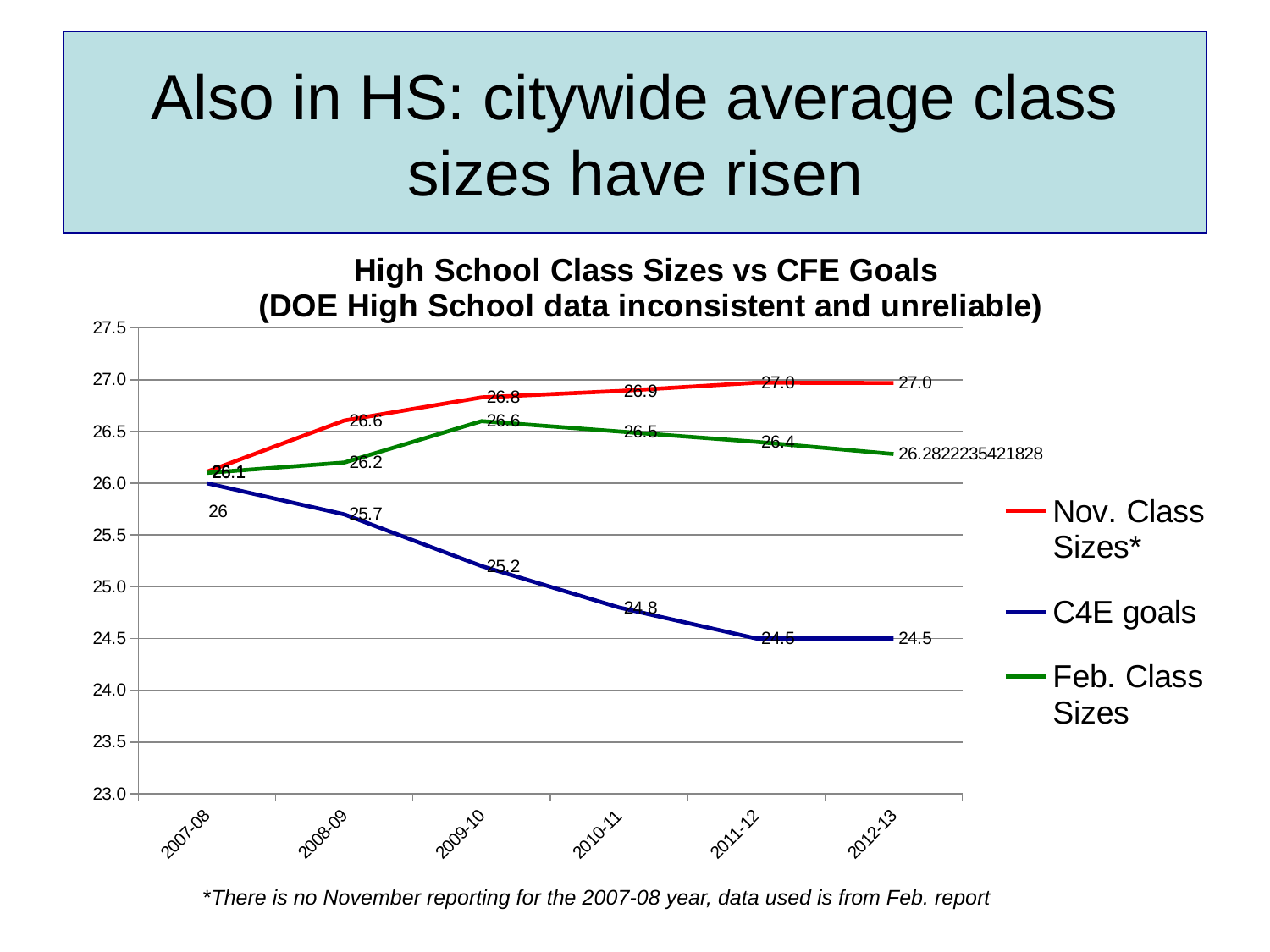
In 2008-09, which is larger: Nov. Class Sizes or Feb. Class Sizes? Nov. Class Sizes What is the C4E goals value for 2009-10? 25.2 What is the difference between the Nov. Class Sizes value and the C4E goals value in 2012-13? 2.5 What is the Feb. Class Sizes value for 2010-11? 26.5 How many school years are plotted along the x axis? 6 What kind of chart is shown on the slide? line chart In which year is the Nov. Class Sizes value lowest? 2007-08 What is the Nov. Class Sizes value for 2011-12? 27.0 How many series does the legend list? 3 What is the C4E goals value for 2008-09? 25.7 Do the C4E goals values rise or fall from 2007-08 to 2011-12? fall In which year is the C4E goals value highest? 2007-08